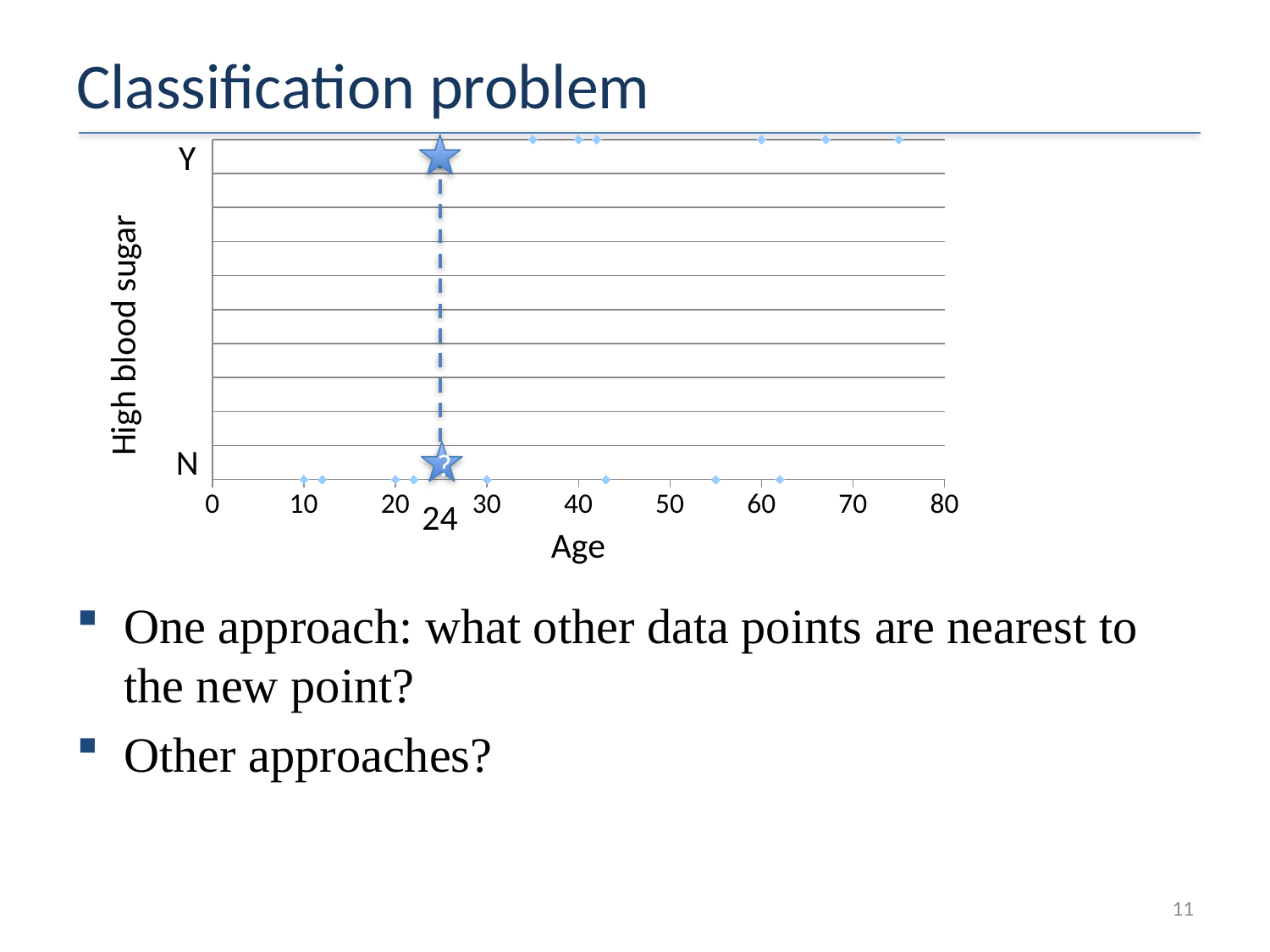
Which row, Y or N, contains the data point with the smallest age? N What is the title of the x axis of the chart? Age Is the age of the leftmost data point in the Y (high blood sugar) row greater or less than 30? greater Is the age of the leftmost data point greater or less than 20? less Which row, Y or N, contains the data point with the largest age? Y What kind of chart is shown on the slide? Scatter chart Is the age of the rightmost data point in the Y (high blood sugar) row greater or less than 70? greater What is the title of the y axis of the chart? High blood sugar How many data points are plotted in the Y (high blood sugar) row? 6 What age is the new point marked with a star and a question mark? 24 What is the highest value shown on the Age axis? 80